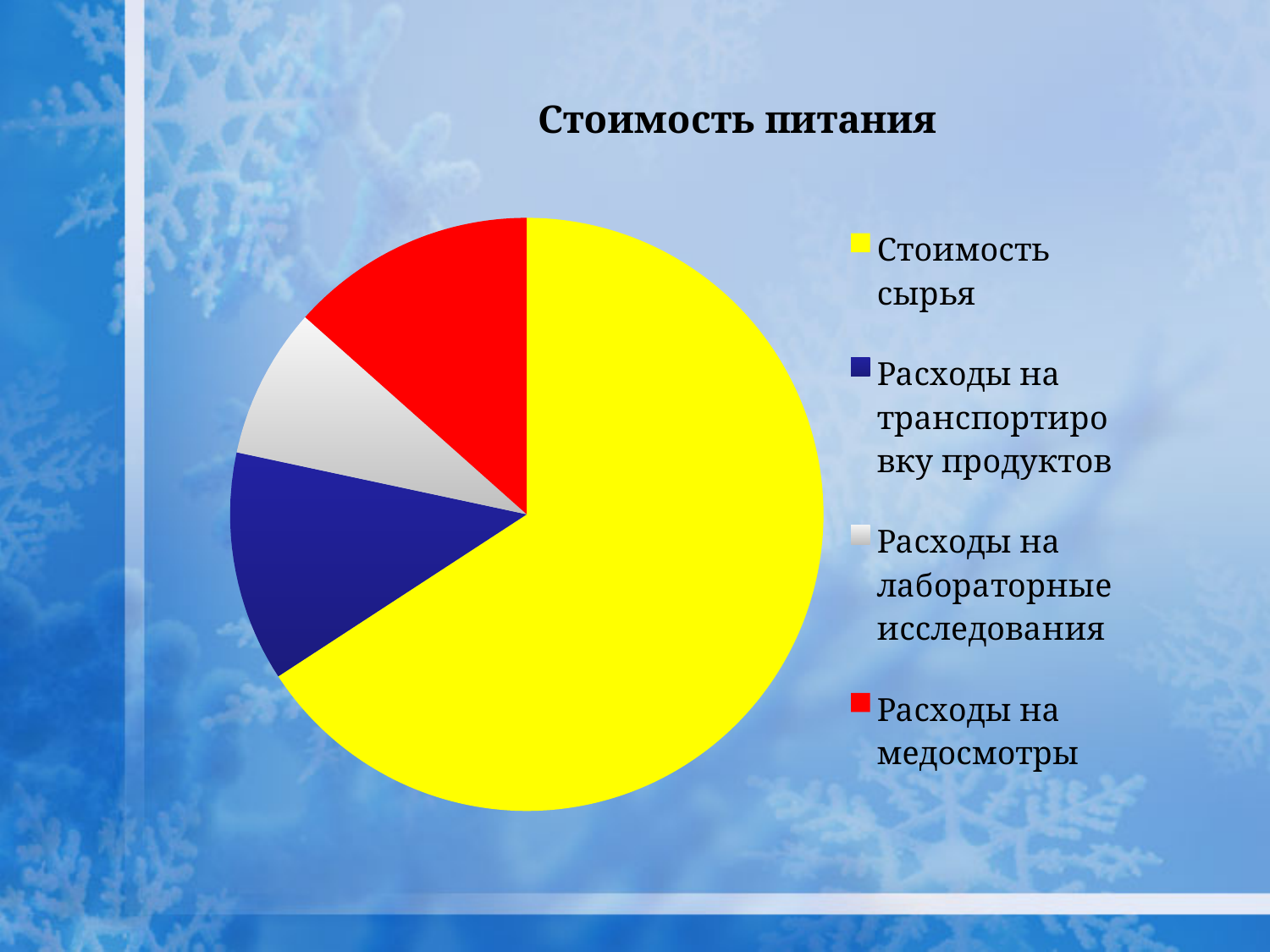
Which category has the largest slice of the pie? Стоимость сырья Which slice is larger: Расходы на транспортировку продуктов or Расходы на лабораторные исследования? Расходы на транспортировку продуктов What kind of chart is shown on the slide? pie chart What colour is the slice for Расходы на медосмотры? red Which category has the smallest slice of the pie? Расходы на лабораторные исследования Which slice is larger: Стоимость сырья or Расходы на медосмотры? Стоимость сырья How many slices does the pie chart have? 4 Does the slice for Стоимость сырья take up more or less than half of the pie? more What is the title of the chart? Стоимость питания How many entries does the legend list? 4